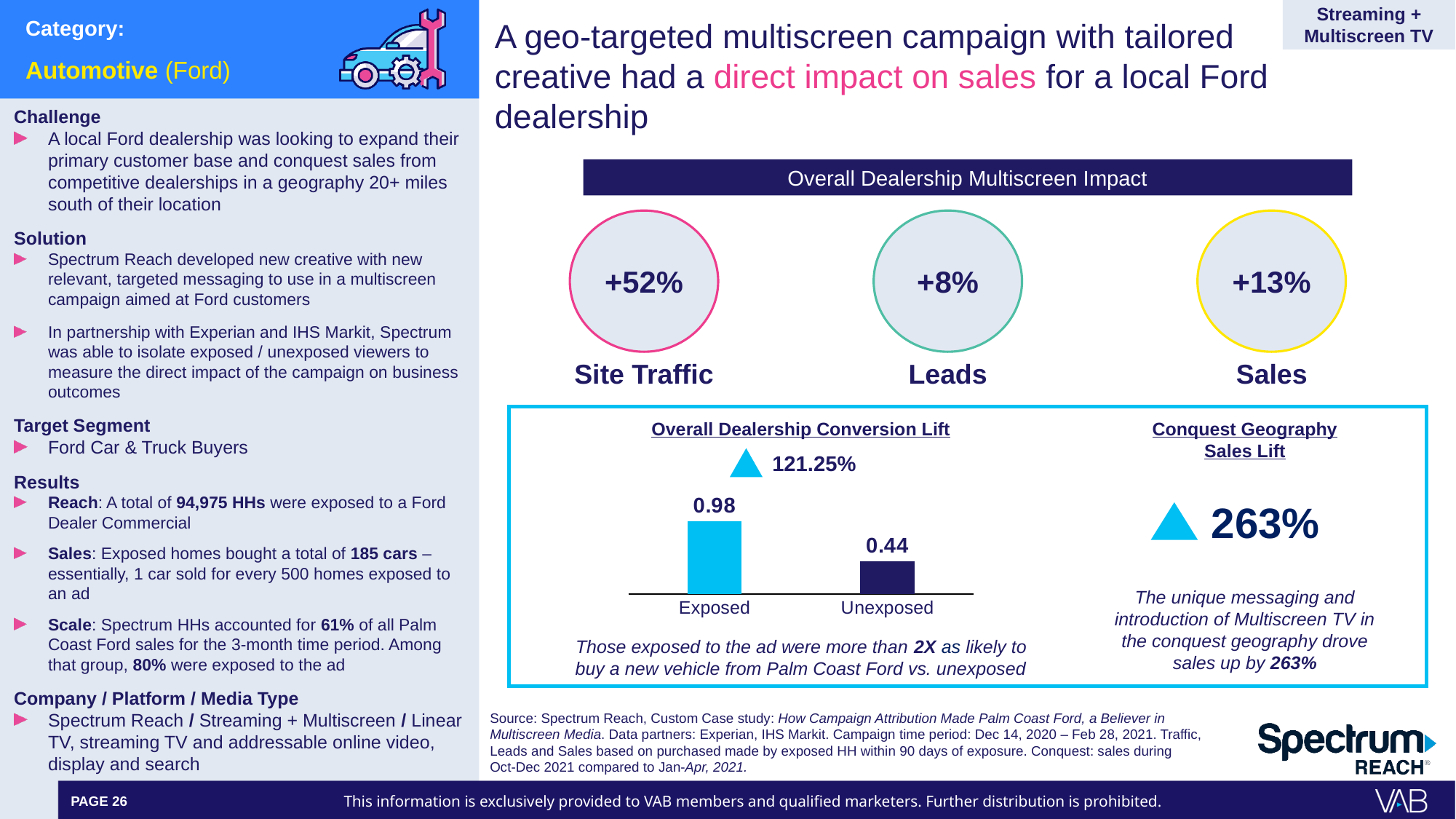
In the Overall Dealership Conversion Lift chart, what is the value for Unexposed? 0.44 In the Overall Dealership Conversion Lift chart, what is the difference between the Exposed and Unexposed values? 0.54 In the Overall Dealership Conversion Lift chart, which category has the highest value? Exposed How many categories are shown in the Overall Dealership Conversion Lift chart? 2 What lift percentage is shown next to the upward triangle above the Overall Dealership Conversion Lift chart? 121.25% What kind of chart is the Overall Dealership Conversion Lift chart? bar chart In the Overall Dealership Conversion Lift chart, do the values rise or fall from Exposed to Unexposed? fall In the Overall Dealership Conversion Lift chart, what is the value for Exposed? 0.98 In the Overall Dealership Conversion Lift chart, which category has the lowest value? Unexposed What is the title of the bar chart on the slide? Overall Dealership Conversion Lift In the Overall Dealership Conversion Lift chart, which is larger, Exposed or Unexposed? Exposed